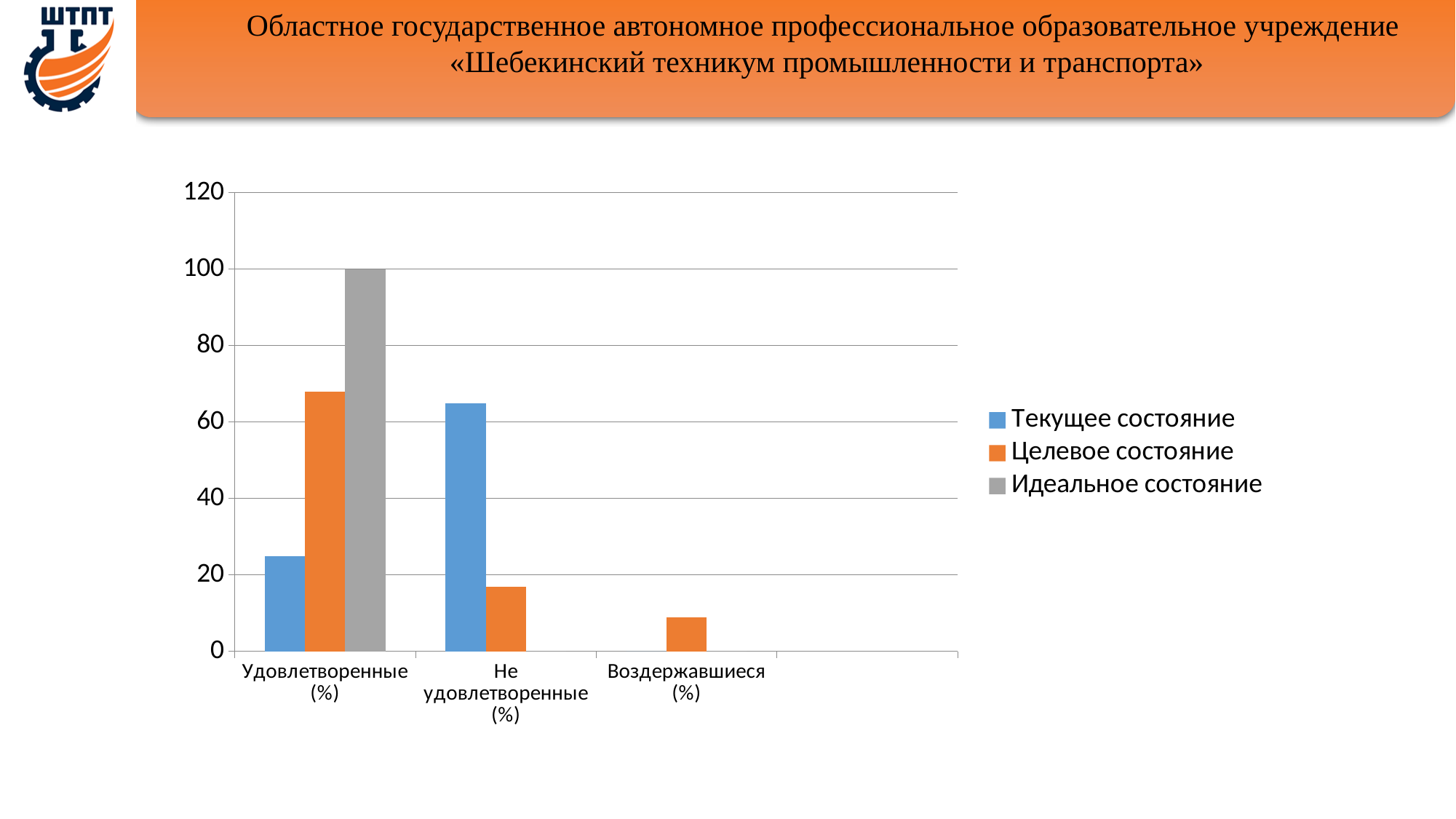
Is the value of Целевое состояние for Не удовлетворенные (%) greater or less than 20? less Which category has the highest value for Текущее состояние? Не удовлетворенные (%) Is the value of Текущее состояние for Не удовлетворенные (%) greater or less than 60? greater What colour represents Целевое состояние in the legend? orange For Удовлетворенные (%), which is larger: Текущее состояние or Целевое состояние? Целевое состояние How many categories are shown on the x axis? 3 How many series does the legend list? 3 Is the value of Целевое состояние for Удовлетворенные (%) greater or less than 60? greater What is the value of Идеальное состояние for Удовлетворенные (%)? 100 What kind of chart is shown on the slide? bar chart